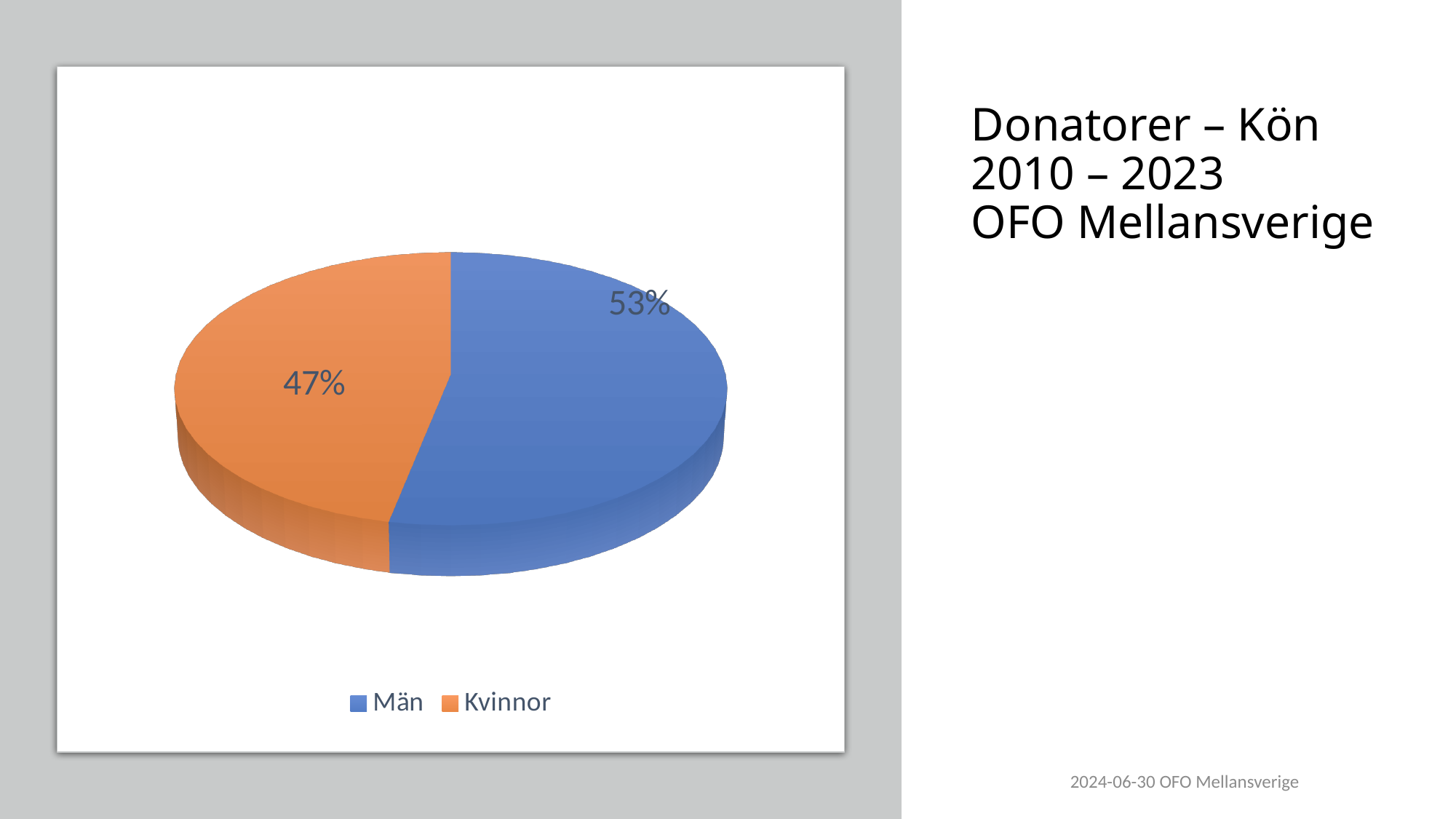
What kind of chart is shown on the slide? Pie chart What share of the pie does Kvinnor represent? 47% What is the title text shown next to the chart? Donatorer – Kön 2010 – 2023 OFO Mellansverige Is the share for Män greater or less than 50%? greater How many slices does the pie chart have? 2 Which category has the largest slice of the pie? Män What is the difference in percentage points between the Män and Kvinnor slices? 6 Which category has the smallest slice of the pie? Kvinnor What colour is the Kvinnor slice? Orange How many entries does the legend list? 2 What share of the pie does Män represent? 53% Which slice is larger, Män or Kvinnor? Män